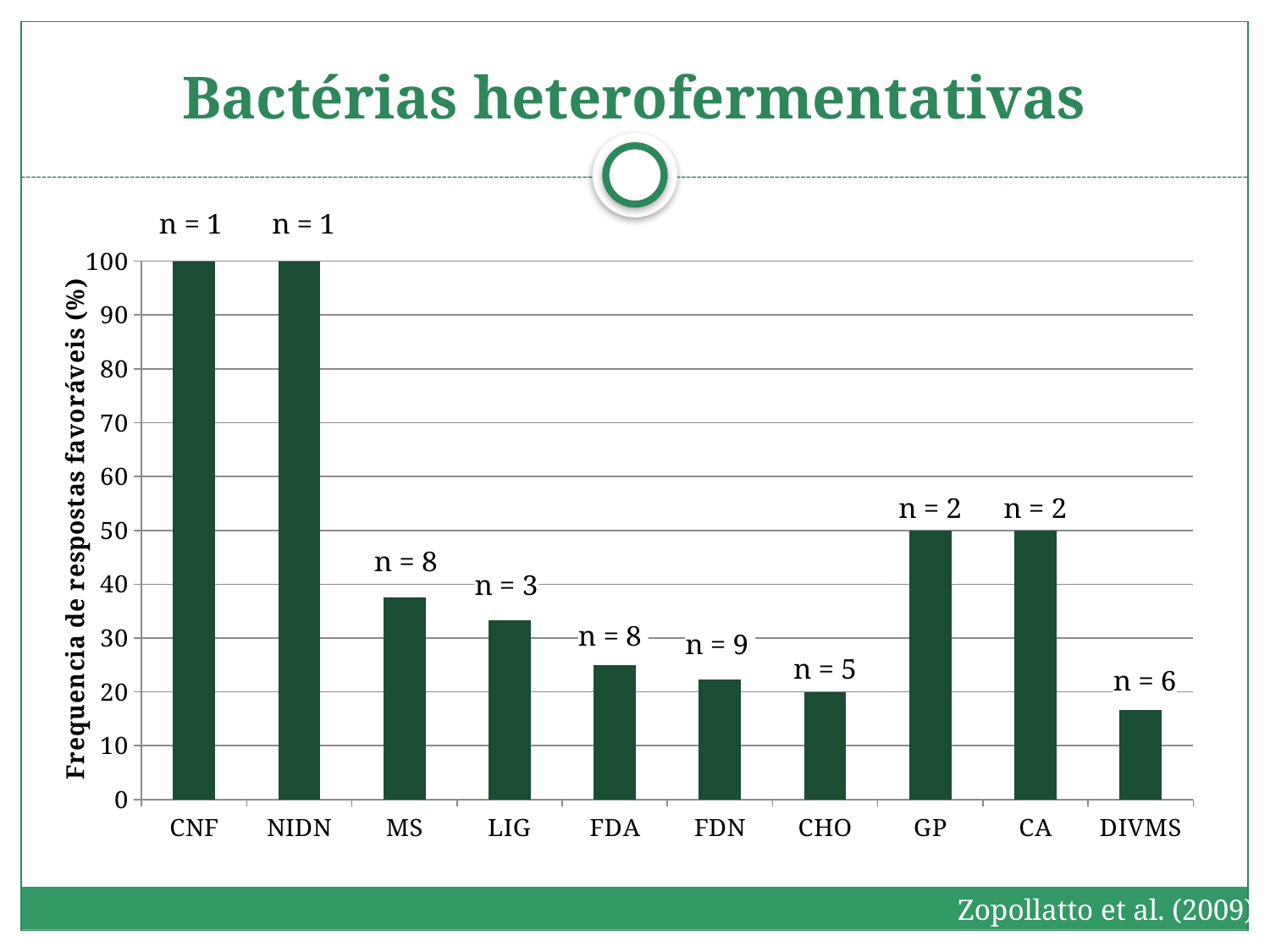
Which has a higher frequency of favourable responses, GP or FDA? GP Is the value for DIVMS greater or less than 20? less What is the frequency of favourable responses (%) for CHO? 20 Which category has the lowest frequency of favourable responses? DIVMS What is the frequency of favourable responses (%) for CNF? 100 What is the n value printed above the FDN bar? n = 9 What is the difference in frequency of favourable responses (%) between NIDN and CA? 50 What type of chart is shown on the slide? bar chart Is the value for MS greater or less than 30? greater What is the frequency of favourable responses (%) for GP? 50 Which categories reach the highest value of 100% on the chart? CNF and NIDN How many categories are shown on the x axis of the chart? 10